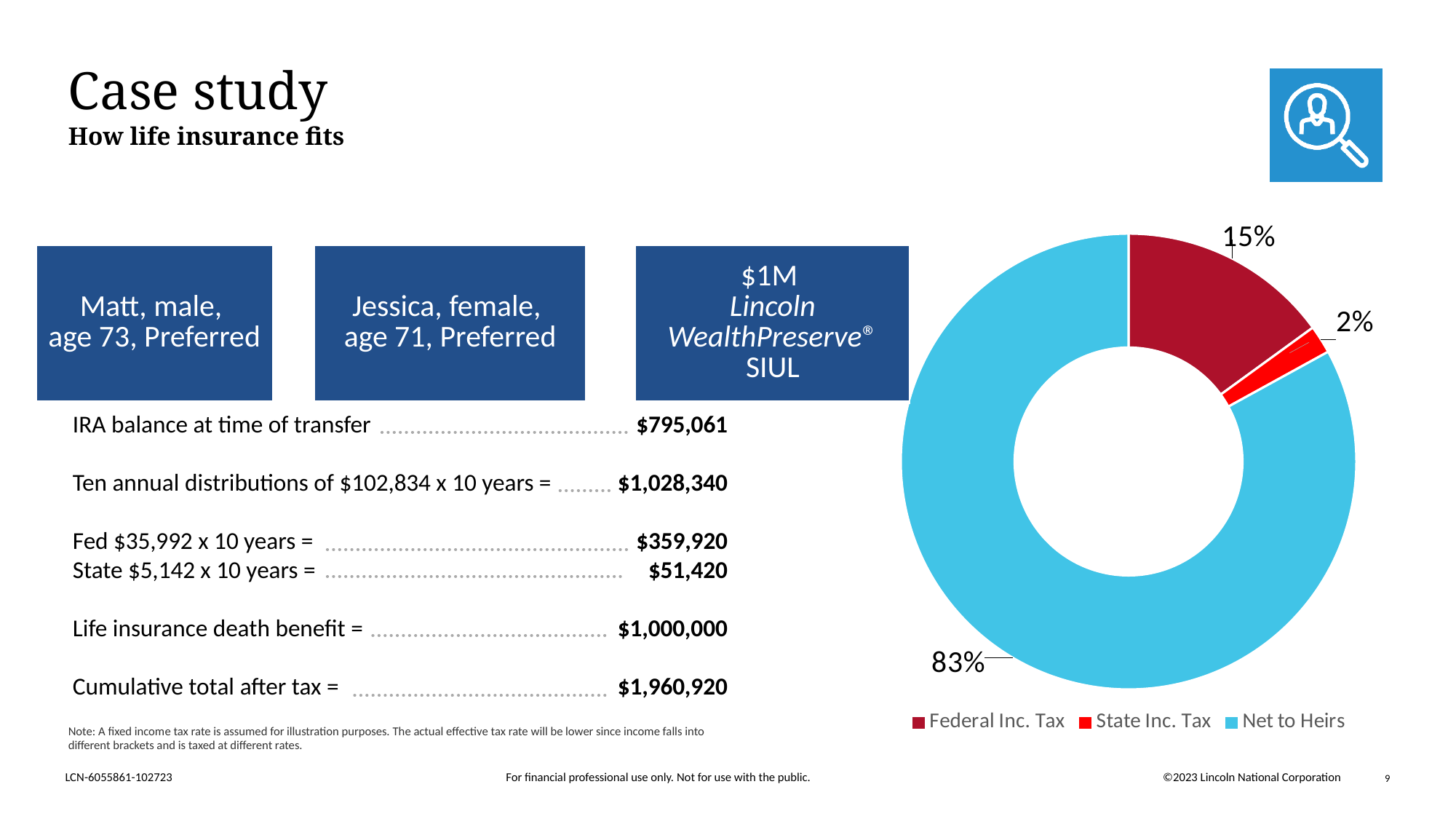
What percentage does the State Inc. Tax slice represent? 2% What is the difference in percentage points between the Net to Heirs slice and the Federal Inc. Tax slice? 68 What percentage does the Federal Inc. Tax slice represent? 15% What is the difference in percentage points between the Federal Inc. Tax slice and the State Inc. Tax slice? 13 What percentage does the Net to Heirs slice represent? 83% How many entries does the legend list? 3 What kind of chart is shown on the slide? Pie chart (doughnut) Which is larger, the Federal Inc. Tax slice or the State Inc. Tax slice? Federal Inc. Tax How many slices does the chart have? 3 What colour is the Net to Heirs slice? Light blue Which slice is the smallest? State Inc. Tax Which slice is the largest? Net to Heirs